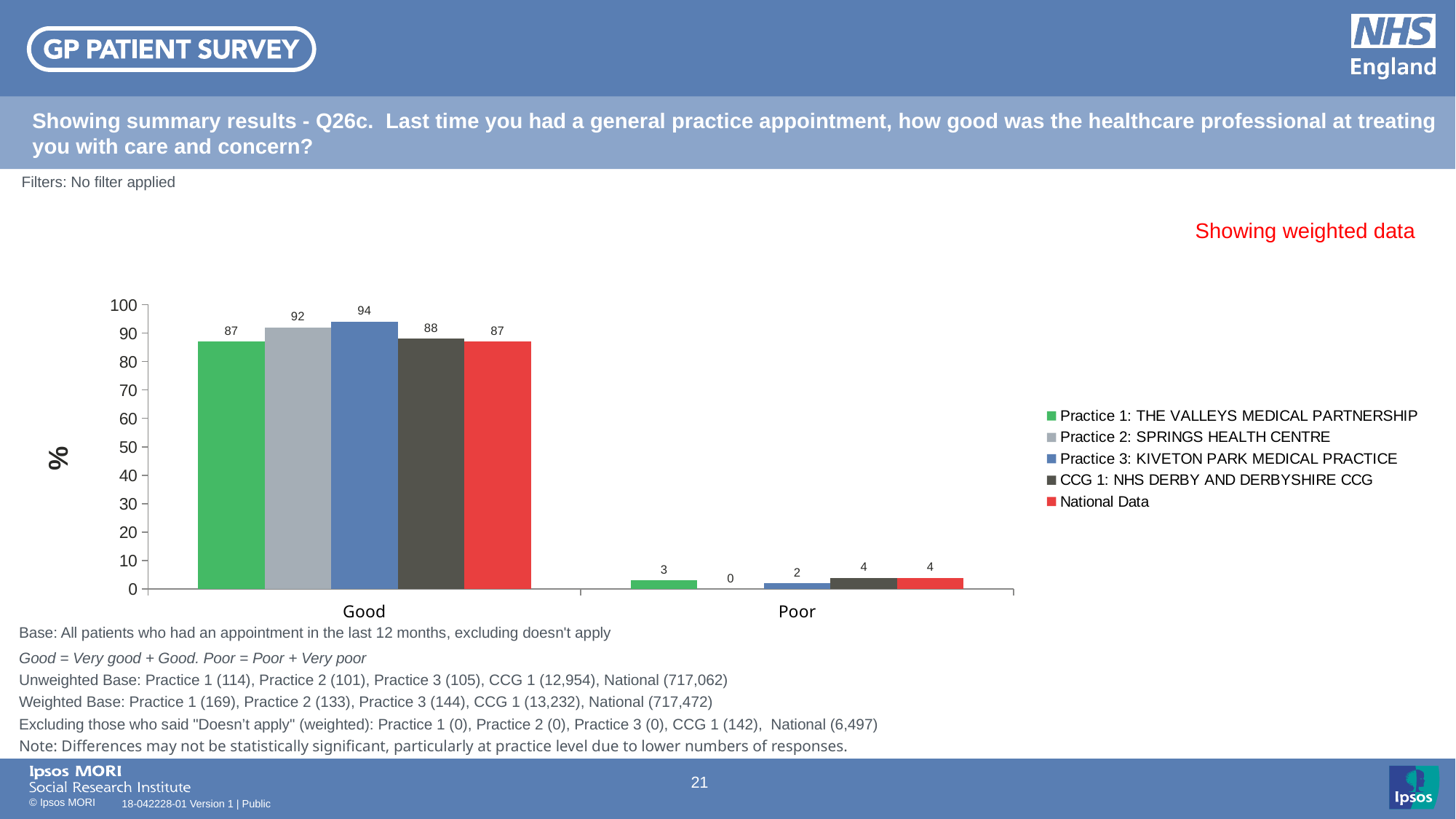
Which series has the highest value in the Good category? Practice 3: KIVETON PARK MEDICAL PRACTICE How many categories are shown on the x axis? 2 What is the difference between Practice 3 and Practice 1 in the Good category? 7 Is the value for Practice 1 in the Good category greater or less than 80? greater What is the value for Practice 2: SPRINGS HEALTH CENTRE in the Poor category? 0 Which is larger in the Good category: Practice 2: SPRINGS HEALTH CENTRE or CCG 1: NHS DERBY AND DERBYSHIRE CCG? Practice 2: SPRINGS HEALTH CENTRE How many series does the legend list? 5 What is the value for Practice 3: KIVETON PARK MEDICAL PRACTICE in the Good category? 94 What kind of chart is shown on the slide? Bar chart What is the value for National Data in the Poor category? 4 Which series has the lowest value in the Poor category? Practice 2: SPRINGS HEALTH CENTRE What colour represents National Data in the chart? Red